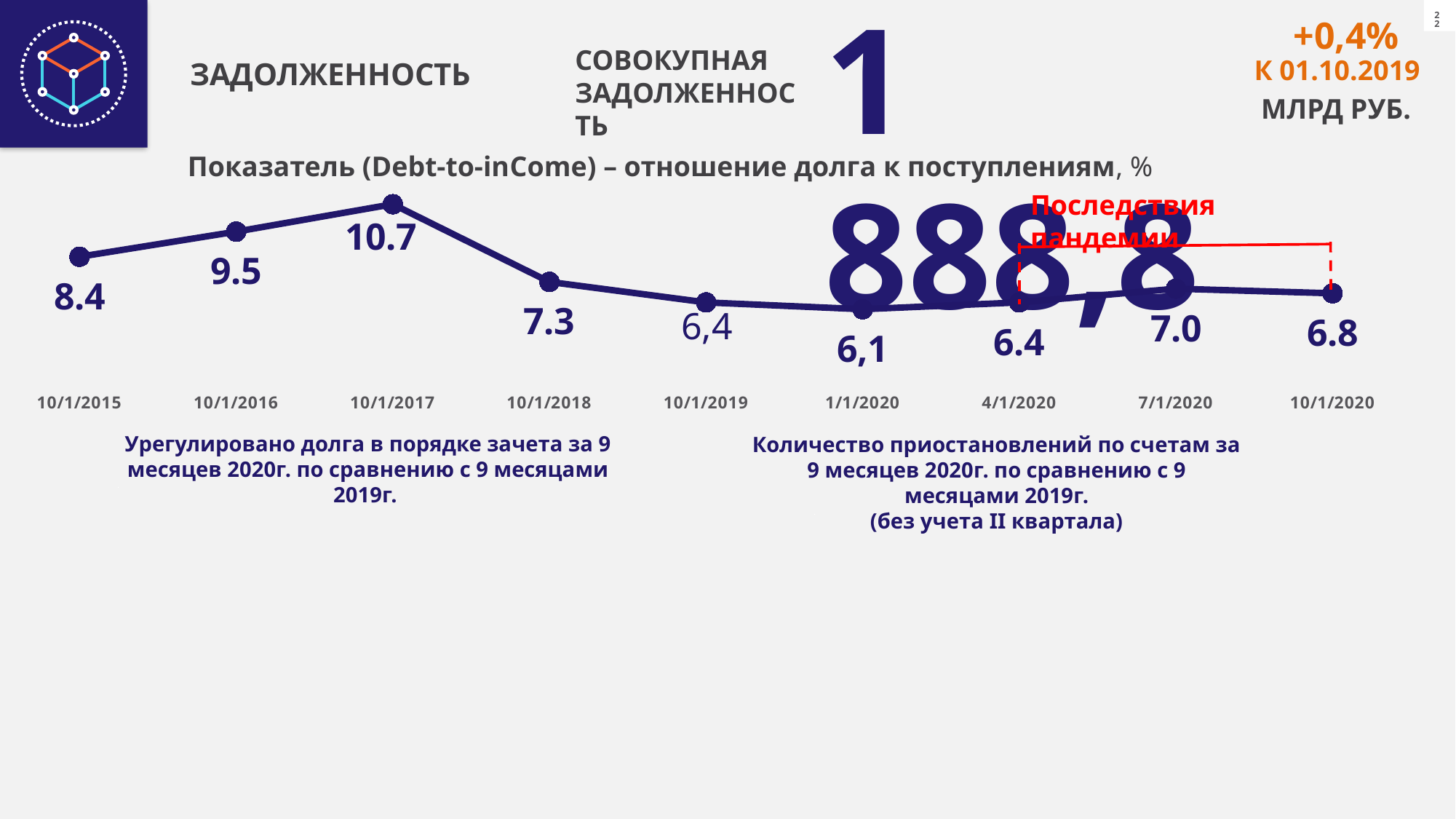
What is the value for 10/1/2017? 10.7 What is the value for 1/1/2020? 6,1 Do the values rise or fall from 10/1/2017 to 1/1/2020? fall What kind of chart is shown on the slide? line chart Which is larger, the value for 10/1/2016 or the value for 7/1/2020? 10/1/2016 What is the value for 10/1/2015? 8.4 What is the title of the chart? Показатель (Debt-to-inCome) – отношение долга к поступлениям, % What is the value for 10/1/2020? 6.8 How many data points are plotted on the line chart? 9 Which date has the lowest value on the chart? 1/1/2020 Which date has the highest value on the chart? 10/1/2017 What is the difference between the values for 10/1/2017 and 10/1/2018? 3.4